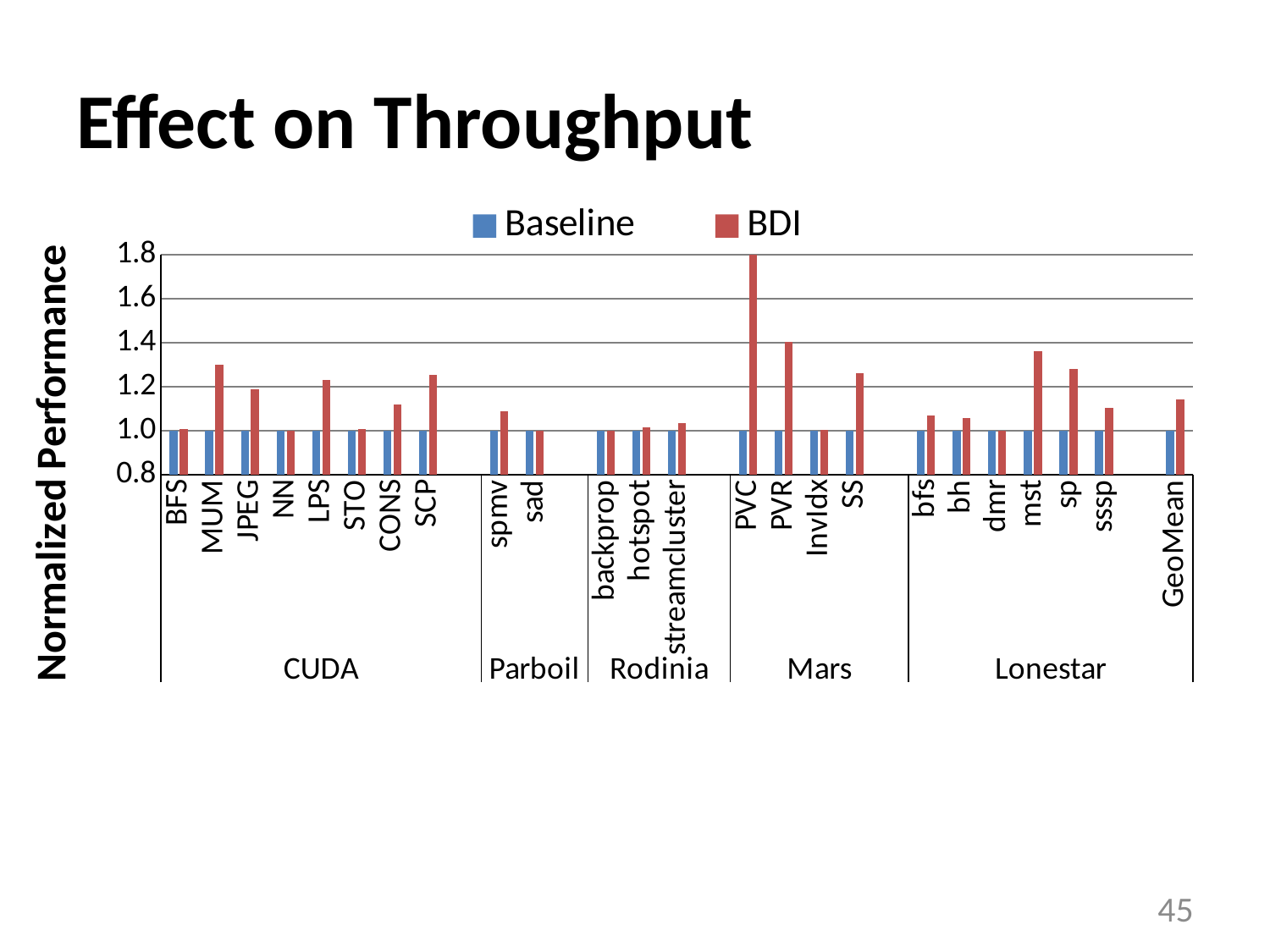
What is the label on the vertical axis? Normalized Performance What is the Baseline value for BFS? 1.0 What kind of chart is shown on the slide? bar chart How many series does the legend list? 2 How many benchmarks are listed under the CUDA group? 8 Is the BDI value for NN greater or less than 1.2? less Which has the larger BDI value, PVC or PVR? PVC Is the BDI value for PVC greater or less than 1.6? greater Which benchmark has the highest BDI value? PVC Is the BDI value for GeoMean greater or less than 1.2? less